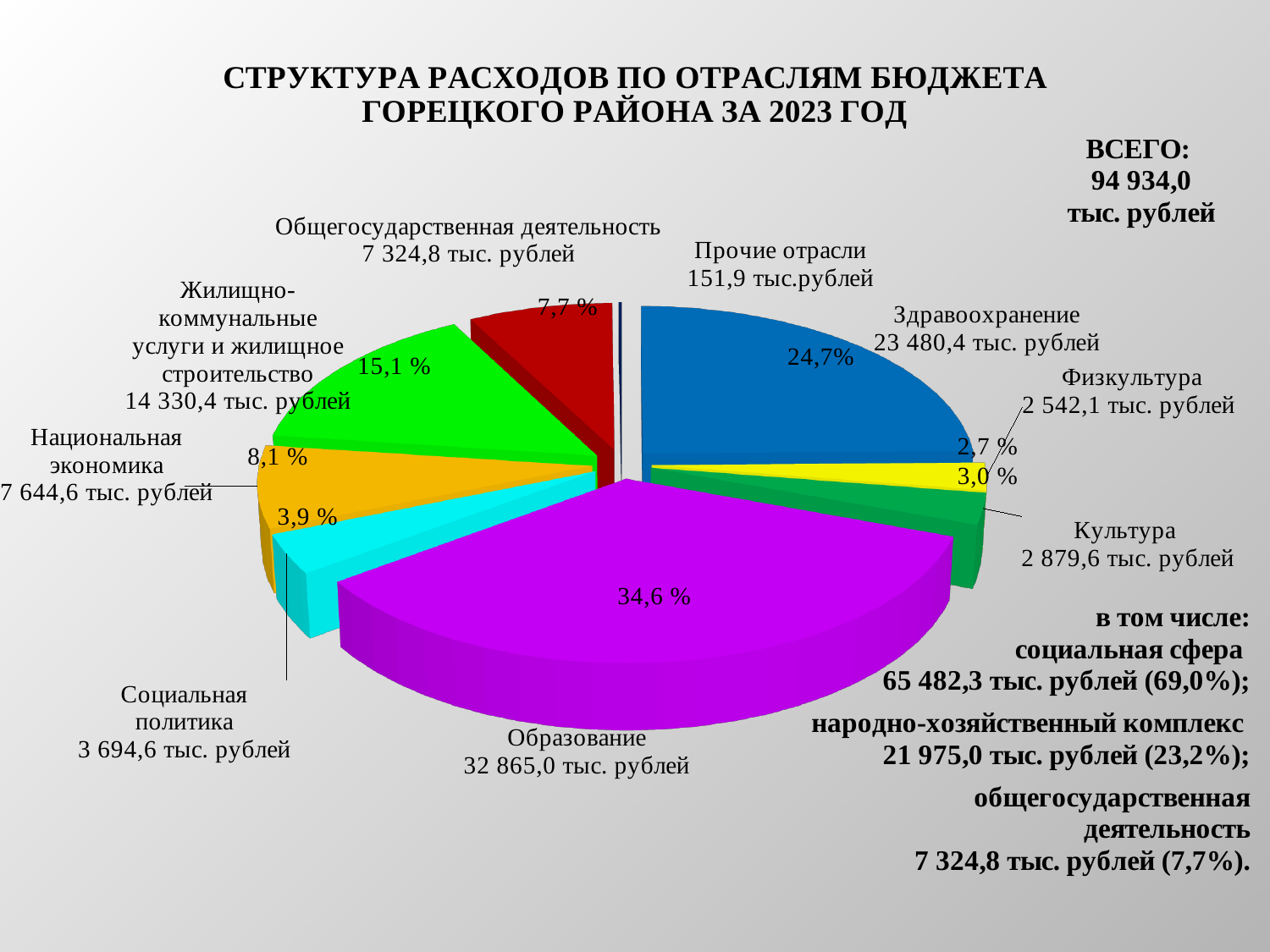
What kind of chart is shown on the slide? pie chart What total expenditure (ВСЕГО) is stated on the slide? 94 934,0 тыс. рублей What share of the pie does Образование account for? 34,6 % Which category has the smallest expenditure in the pie chart? Прочие отрасли What is the expenditure for Здравоохранение? 23 480,4 тыс. рублей How many sectors (categories) does the pie chart show? 9 What is the expenditure for Жилищно-коммунальные услуги и жилищное строительство? 14 330,4 тыс. рублей Which is larger: the expenditure for Культура or for Физкультура? Культура What share of the pie does Национальная экономика account for? 8,1 % What is the difference between the expenditure for Национальная экономика and for Общегосударственная деятельность? 319,8 тыс. рублей Which category has the largest expenditure in the pie chart? Образование What is the difference between the expenditure for Образование and for Здравоохранение? 9 384,6 тыс. рублей